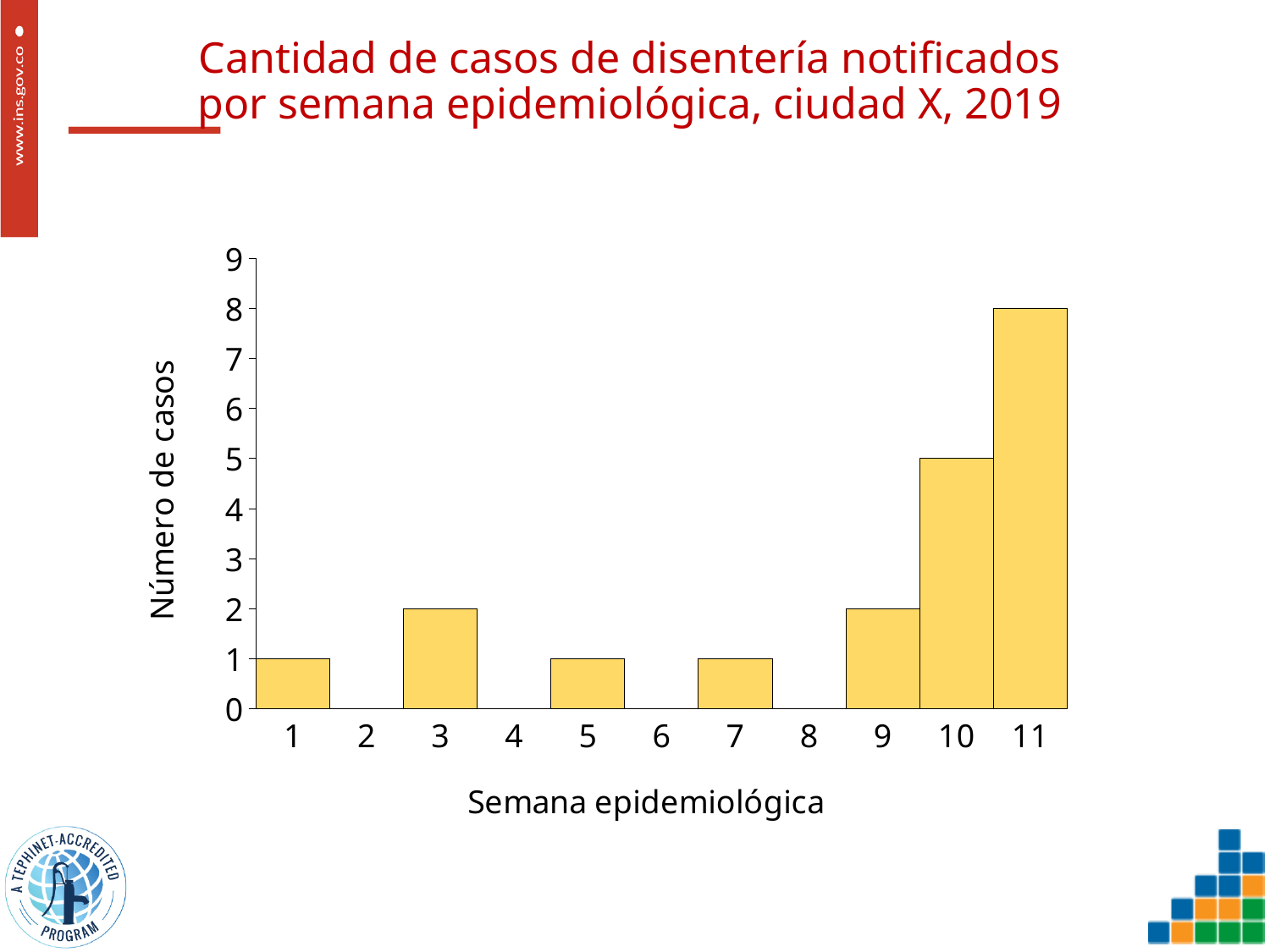
Which epidemiological week has the highest number of cases? 11 What is the label of the y axis? Número de casos How many cases were reported in epidemiological week 1? 1 How many epidemiological weeks are shown on the x axis? 11 How many cases were reported in epidemiological week 3? 2 How many cases were reported in epidemiological week 10? 5 What is the title of the chart? Cantidad de casos de disentería notificados por semana epidemiológica, ciudad X, 2019 What is the difference in the number of cases between week 11 and week 10? 3 How many cases were reported in epidemiological week 11? 8 Which has more cases, week 9 or week 10? week 10 What kind of chart is shown on the slide? bar chart Is the number of cases in week 11 greater or less than 5? greater